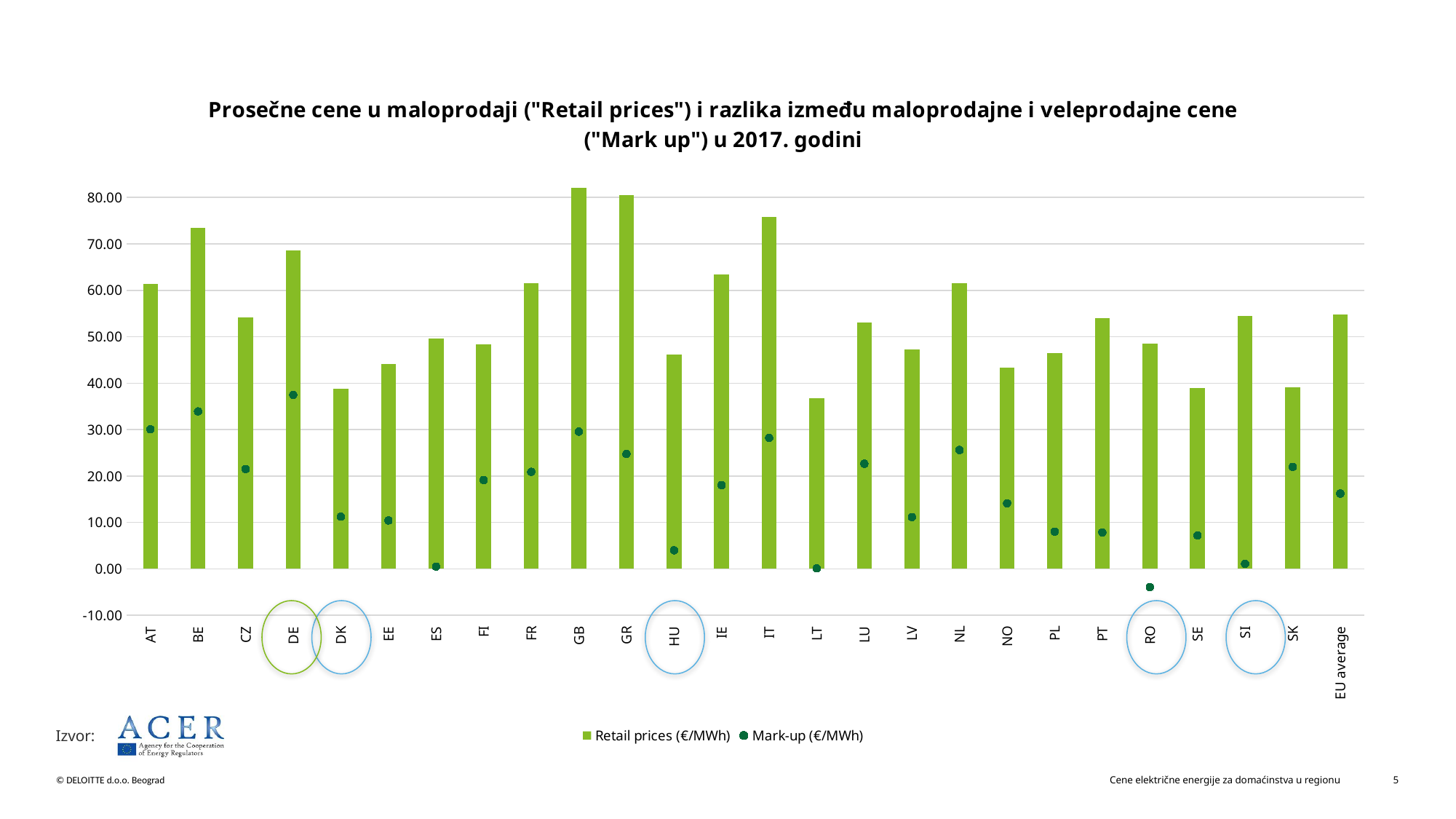
How many series does the legend list? 2 Which has the larger retail price, BE or CZ? BE Is the retail price for BE greater or less than 70.00? greater Which category has the lowest mark-up value? RO Is the retail price for LT greater or less than 40.00? less What kind of chart is shown on the slide? bar chart Which category has the highest mark-up value? DE Is the mark-up for HU greater or less than 10.00? less Which category has the highest retail price bar? GB How many categories are shown on the x axis? 26 What unit is given for the Retail prices series in the legend? €/MWh